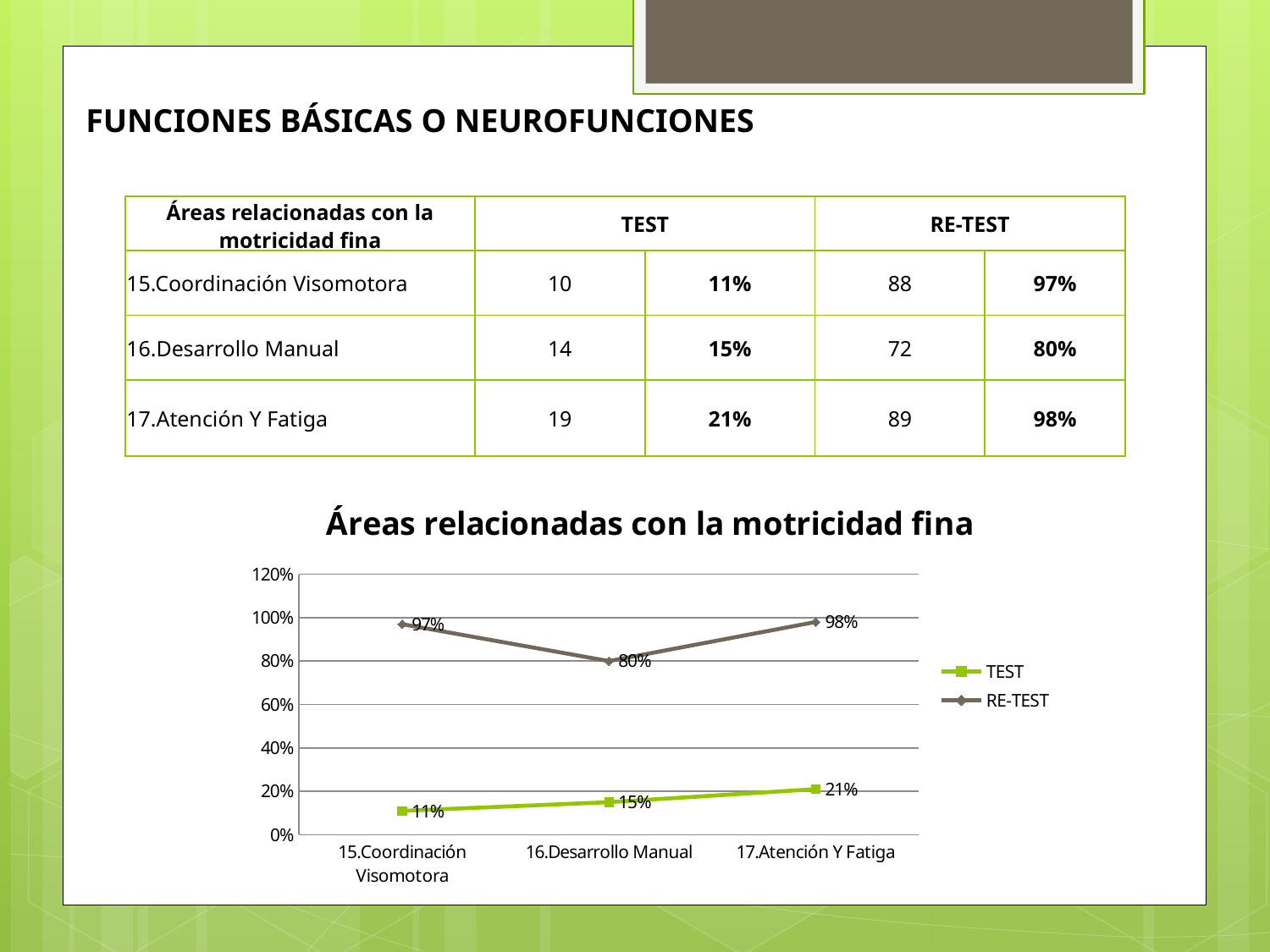
What is the TEST value for 15.Coordinación Visomotora? 11% What is the TEST value for 17.Atención Y Fatiga? 21% How many categories are shown on the x axis? 3 What is the RE-TEST value for 16.Desarrollo Manual? 80% What is the difference between the RE-TEST and TEST values for 15.Coordinación Visomotora? 86% Do the TEST values rise or fall from left to right along the x axis? Rise What kind of chart is shown? Line chart How many series does the legend list? 2 What is the title of the chart? Áreas relacionadas con la motricidad fina Which category has the lowest TEST value? 15.Coordinación Visomotora Which is larger for 16.Desarrollo Manual, the TEST value or the RE-TEST value? RE-TEST Which category has the highest RE-TEST value? 17.Atención Y Fatiga